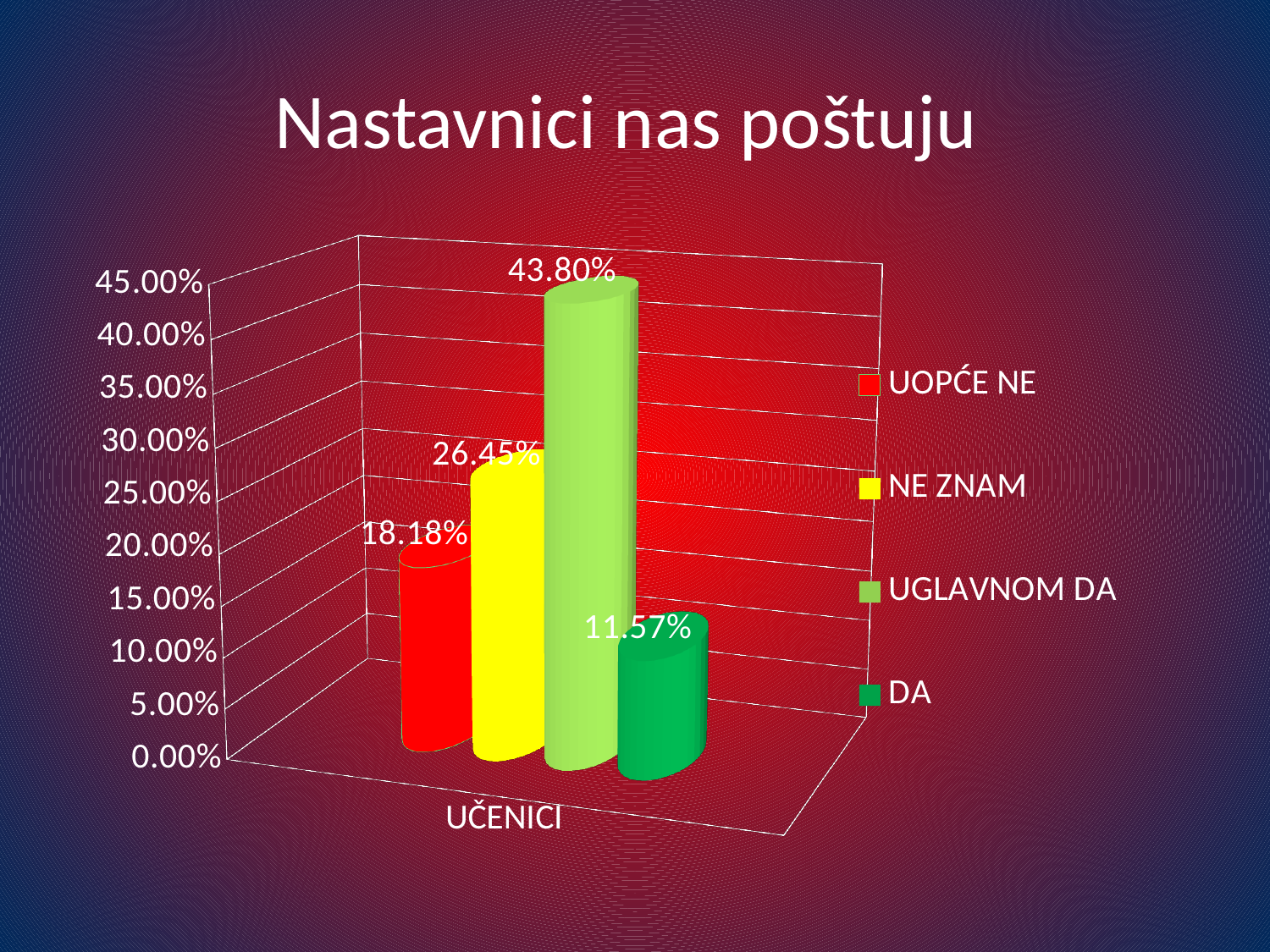
Which series has the highest value? UGLAVNOM DA Which series has the lowest value? DA What kind of chart is shown on the slide? Bar chart What is the difference between the values for UGLAVNOM DA and NE ZNAM? 17.35% What is the value for DA? 11.57% What is the value for UOPĆE NE? 18.18% What is the value for NE ZNAM? 26.45% What is the difference between the values for UOPĆE NE and DA? 6.61% Which is larger, the value for NE ZNAM or the value for UOPĆE NE? NE ZNAM What is the title of the chart? Nastavnici nas poštuju What is the value for UGLAVNOM DA? 43.80% How many series does the legend list? 4